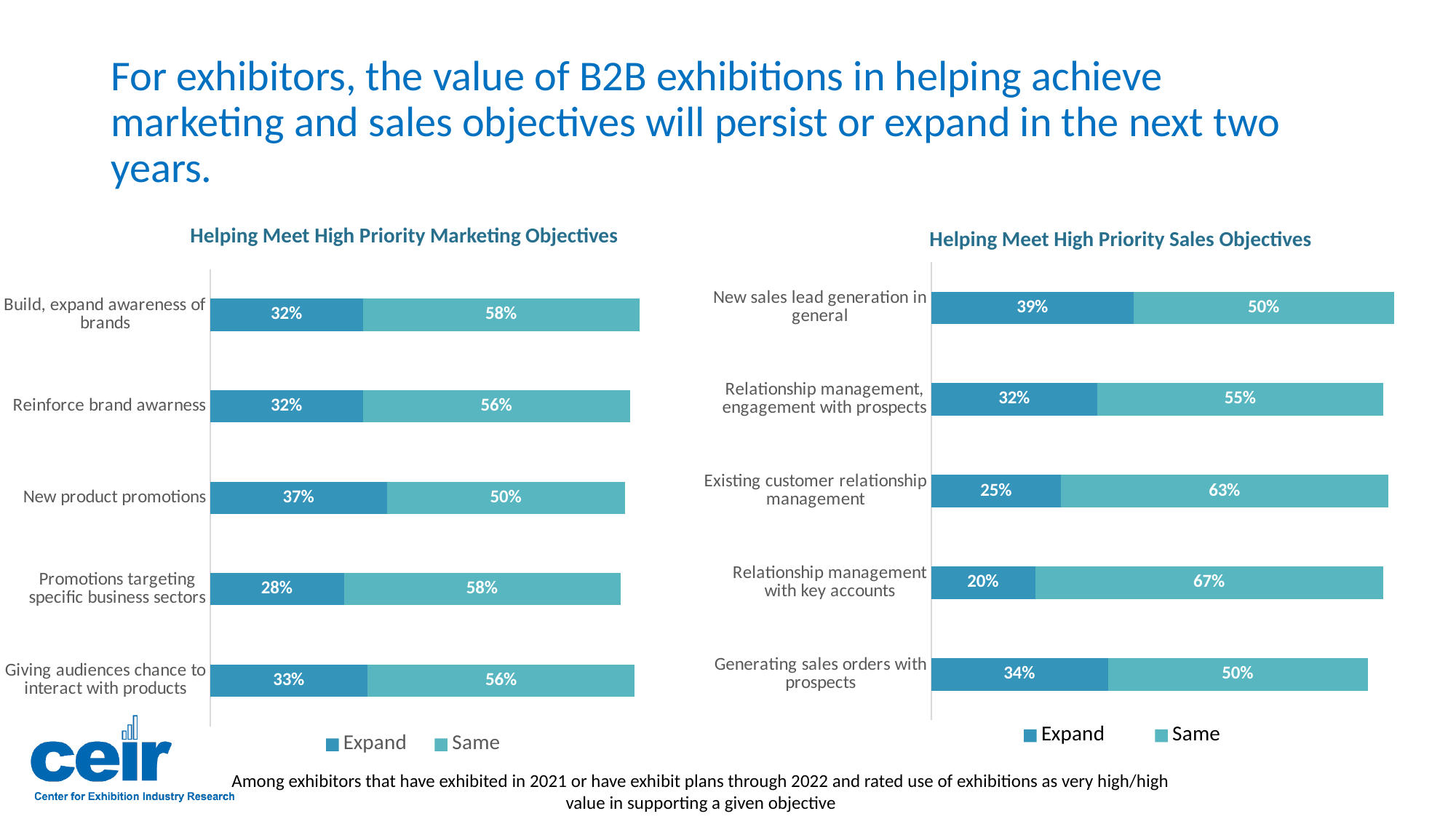
In the 'Helping Meet High Priority Sales Objectives' chart, which category has the lowest Expand value? Relationship management with key accounts What type of chart is the 'Helping Meet High Priority Marketing Objectives' chart? Stacked bar chart How many categories are shown in the 'Helping Meet High Priority Sales Objectives' chart? 5 In the 'Helping Meet High Priority Sales Objectives' chart, what is the Same value for Relationship management with key accounts? 67% In the 'Helping Meet High Priority Sales Objectives' chart, what is the difference between the Same and Expand values for Existing customer relationship management? 38% In the 'Helping Meet High Priority Marketing Objectives' chart, what is the total of the Expand and Same values for Build, expand awareness of brands? 90% In the 'Helping Meet High Priority Marketing Objectives' chart, is the Same value for Reinforce brand awarness larger or smaller than the Same value for Promotions targeting specific business sectors? smaller In the 'Helping Meet High Priority Sales Objectives' chart, what is the total of the Expand and Same values for Relationship management, engagement with prospects? 87% In the 'Helping Meet High Priority Marketing Objectives' chart, which category has the lowest Expand value? Promotions targeting specific business sectors How many series does the legend of the 'Helping Meet High Priority Marketing Objectives' chart list? 2 In the 'Helping Meet High Priority Sales Objectives' chart, which category has the highest Expand value? New sales lead generation in general In the 'Helping Meet High Priority Marketing Objectives' chart, what is the Expand value for New product promotions? 37%